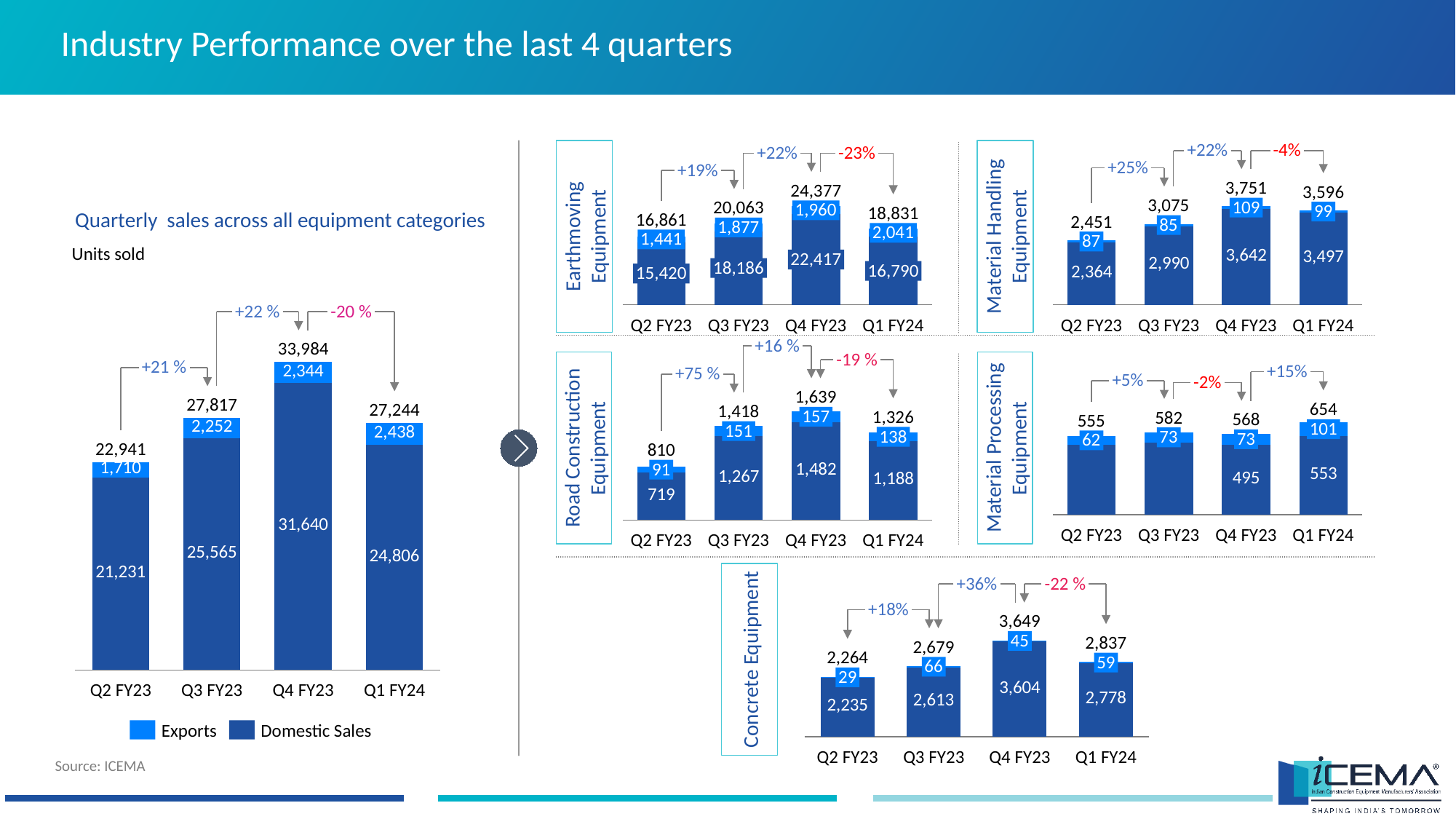
How many series does the legend of the 'Quarterly sales across all equipment categories' chart list? 2 In the Concrete Equipment chart, what is the total for Q4 FY23? 3,649 How many quarters are shown on the x axis of the Material Processing Equipment chart? 4 In the 'Quarterly sales across all equipment categories' chart, which quarter has the highest total units sold? Q4 FY23 In the 'Quarterly sales across all equipment categories' chart, how much higher are Exports in Q1 FY24 than in Q2 FY23? 728 In the Material Processing Equipment chart, what is the difference between the Q1 FY24 total and the Q4 FY23 total? 86 In the Road Construction Equipment chart, which quarter has the lowest total? Q2 FY23 What kind of chart is the 'Quarterly sales across all equipment categories' chart? Stacked bar chart In the Material Handling Equipment chart, which quarter has higher Exports, Q4 FY23 or Q1 FY24? Q4 FY23 In the 'Quarterly sales across all equipment categories' chart, what is the Domestic Sales value for Q4 FY23? 31,640 In the Earthmoving Equipment chart, what is the Exports value for Q1 FY24? 2,041 In the 'Quarterly sales across all equipment categories' chart, what percentage change is labelled between Q4 FY23 and Q1 FY24? -20 %